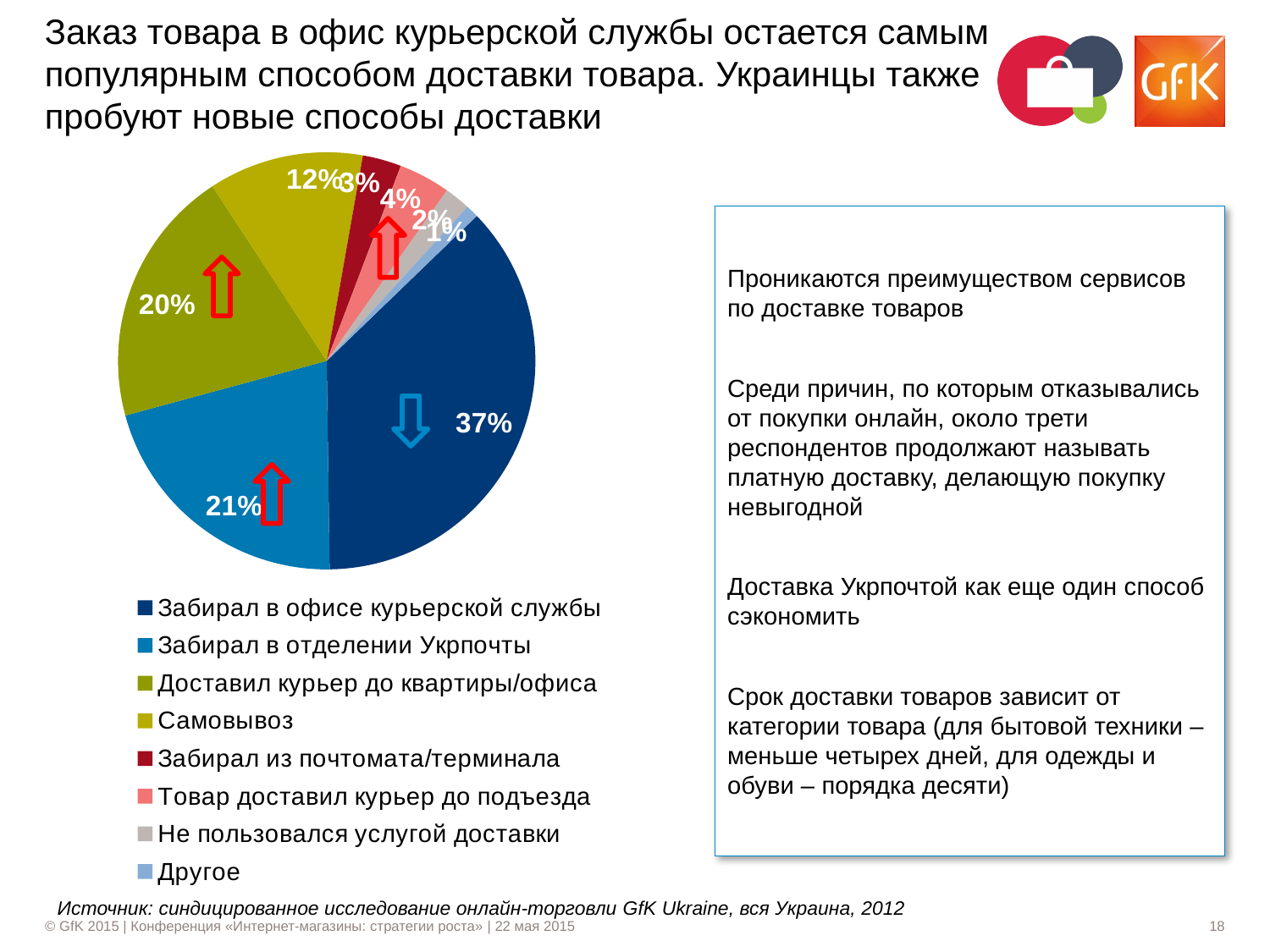
What share of the pie does "Забирал в отделении Укрпочты" have? 21% Which is larger: the slice for "Самовывоз" or the slice for "Доставил курьер до квартиры/офиса"? Доставил курьер до квартиры/офиса Which category has the largest slice of the pie? Забирал в офисе курьерской службы What share of the pie does "Самовывоз" have? 12% What is the combined share of "Забирал в офисе курьерской службы" and "Забирал в отделении Укрпочты"? 58% What is the difference in percentage points between "Забирал в офисе курьерской службы" and "Забирал в отделении Укрпочты"? 16 What colour is the slice for "Забирал в отделении Укрпочты"? blue How many categories does the legend of the pie chart list? 8 Which category has the smallest slice of the pie? Другое What share of the pie does "Забирал в офисе курьерской службы" have? 37% What share of the pie does "Доставил курьер до квартиры/офиса" have? 20% What kind of chart is shown on the slide? pie chart